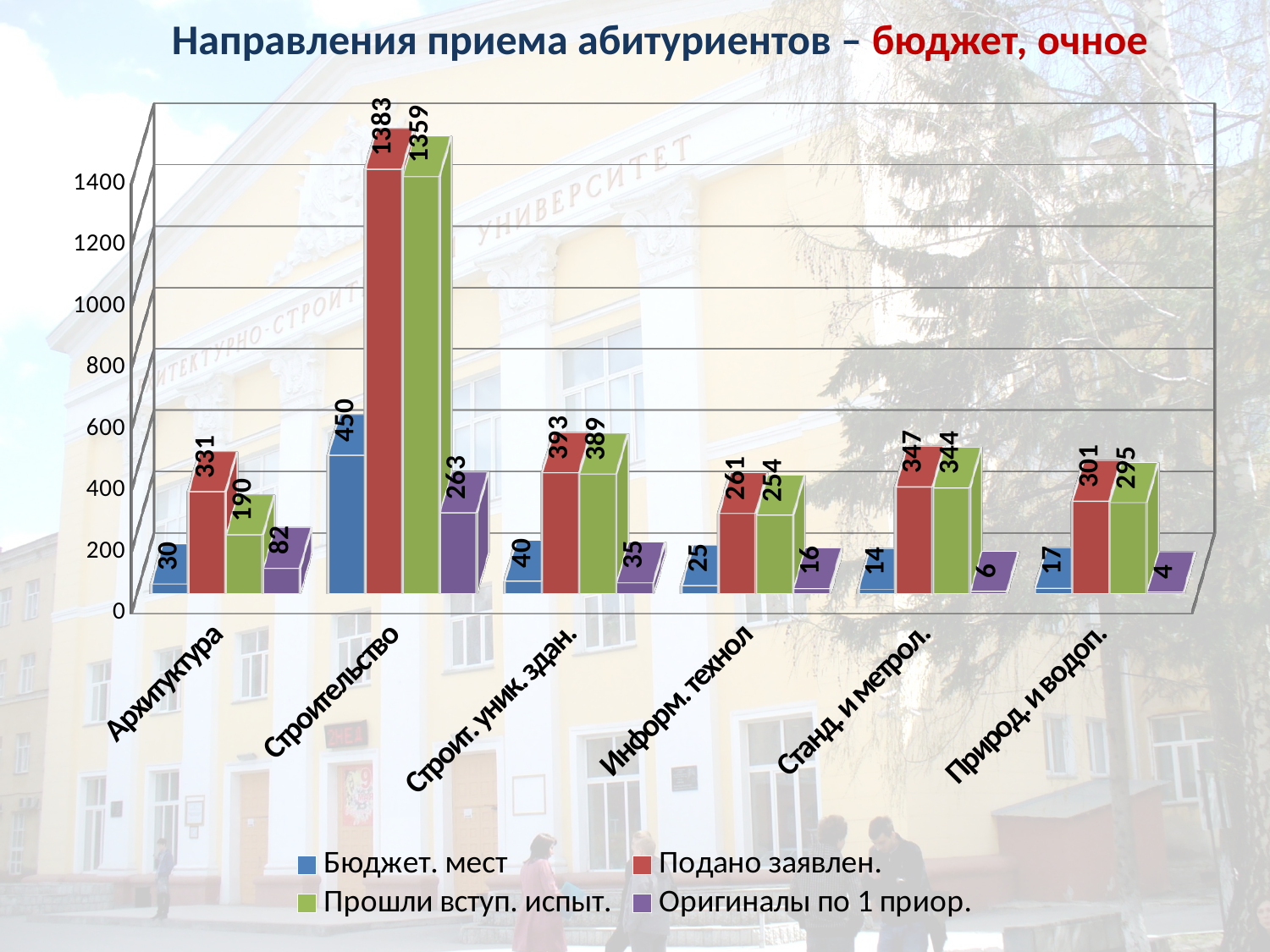
How many applications (Подано заявлен.) were submitted for Строительство? 1383 What is the title of the chart on the slide? Направления приема абитуриентов – бюджет, очное How many categories are shown on the x axis? 6 Which category has the lowest value for Оригиналы по 1 приор.? Природ. и водоп. What kind of chart is shown on the slide? bar chart Is the value of Прошли вступ. испыт. for Строительство greater or less than 1200? greater How many Бюджет. мест are shown for Информ. технол? 25 Which category has the highest number of Подано заявлен.? Строительство Which is larger for Станд. и метрол.: Подано заявлен. or Прошли вступ. испыт.? Подано заявлен. What is the difference between Подано заявлен. and Прошли вступ. испыт. for Архитектура? 141 How many series does the legend list? 4 What is the value of Оригиналы по 1 приор. for Архитектура? 82